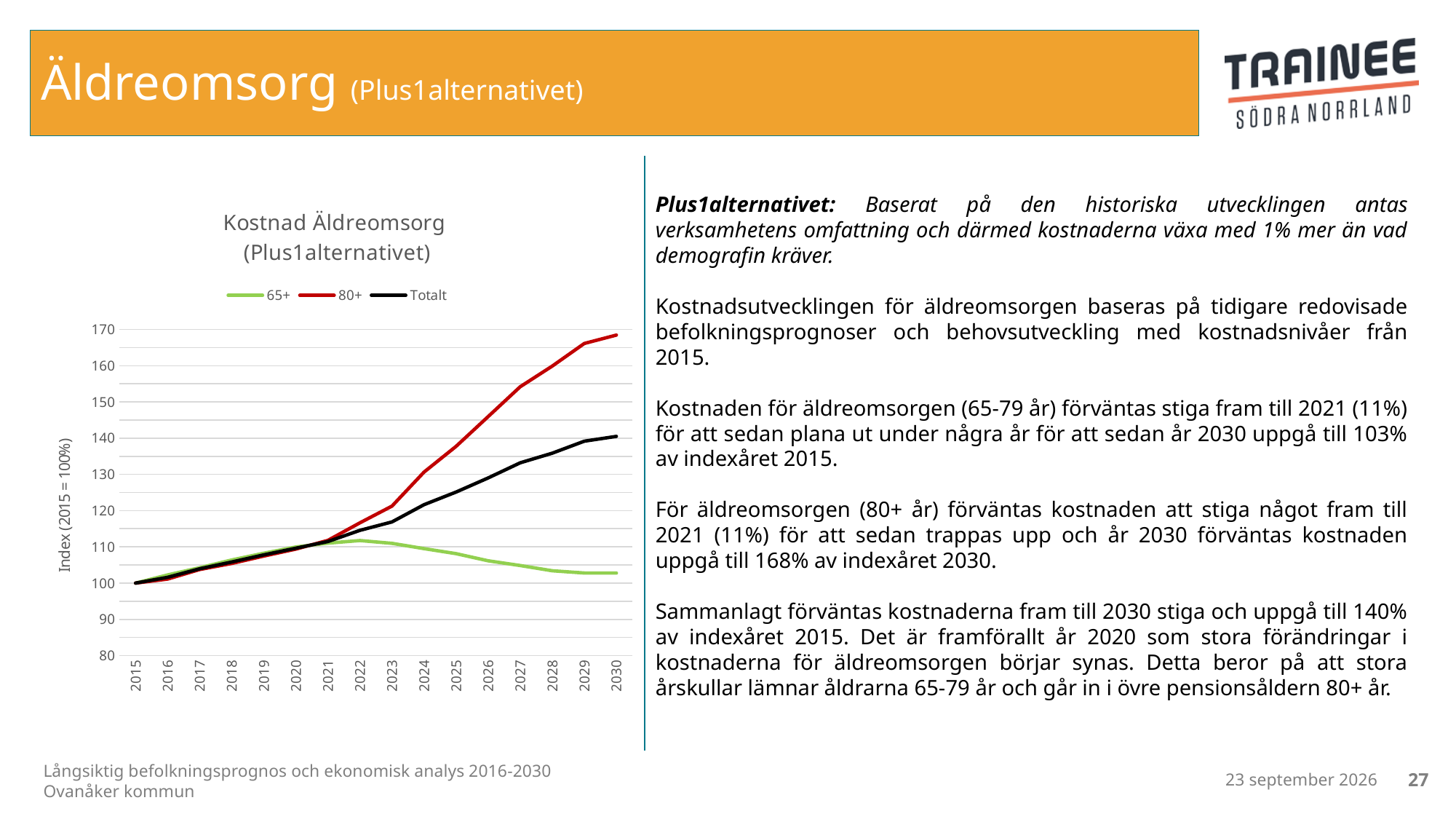
Is the value for 65+ in 2030 greater or less than 110? less What is the label on the y axis of the chart? Index (2015 = 100%) What is the index value for all three series in 2015? 100 Which series has the highest value in 2030? 80+ Does the 80+ series rise or fall from 2015 to 2030? rise Is the value for 80+ in 2030 greater or less than 160? greater How many years are shown on the x axis of the chart? 16 Is the value for Totalt in 2025 greater or less than 120? greater In 2030, which series is larger, 80+ or Totalt? 80+ How many series does the legend of the chart list? 3 Which series has the lowest value in 2030? 65+ What kind of chart is shown on the slide? Line chart